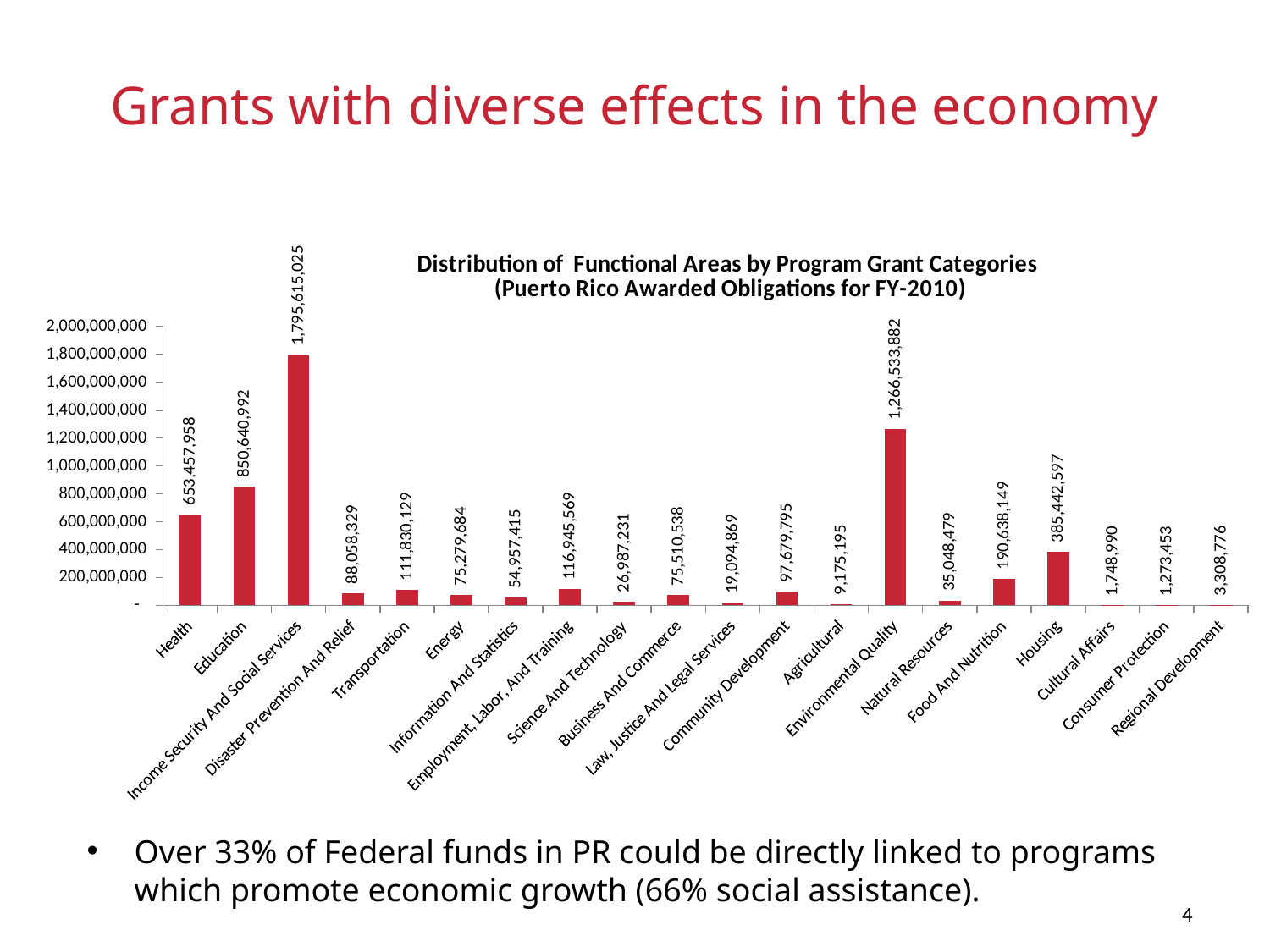
What is the difference between Income Security And Social Services and Environmental Quality? 529,081,143 What is the value for Agricultural? 9,175,195 What is the difference between Education and Health? 197,183,034 What is the value for Environmental Quality? 1,266,533,882 What is the value for Housing? 385,442,597 What is the value for Health? 653,457,958 How many categories are shown on the x axis? 20 Which category has the highest value? Income Security And Social Services Which is larger, Health or Housing? Health Which category has the lowest value? Consumer Protection What kind of chart is shown on the slide? Bar chart Is the value for Environmental Quality greater or less than 1,200,000,000? greater